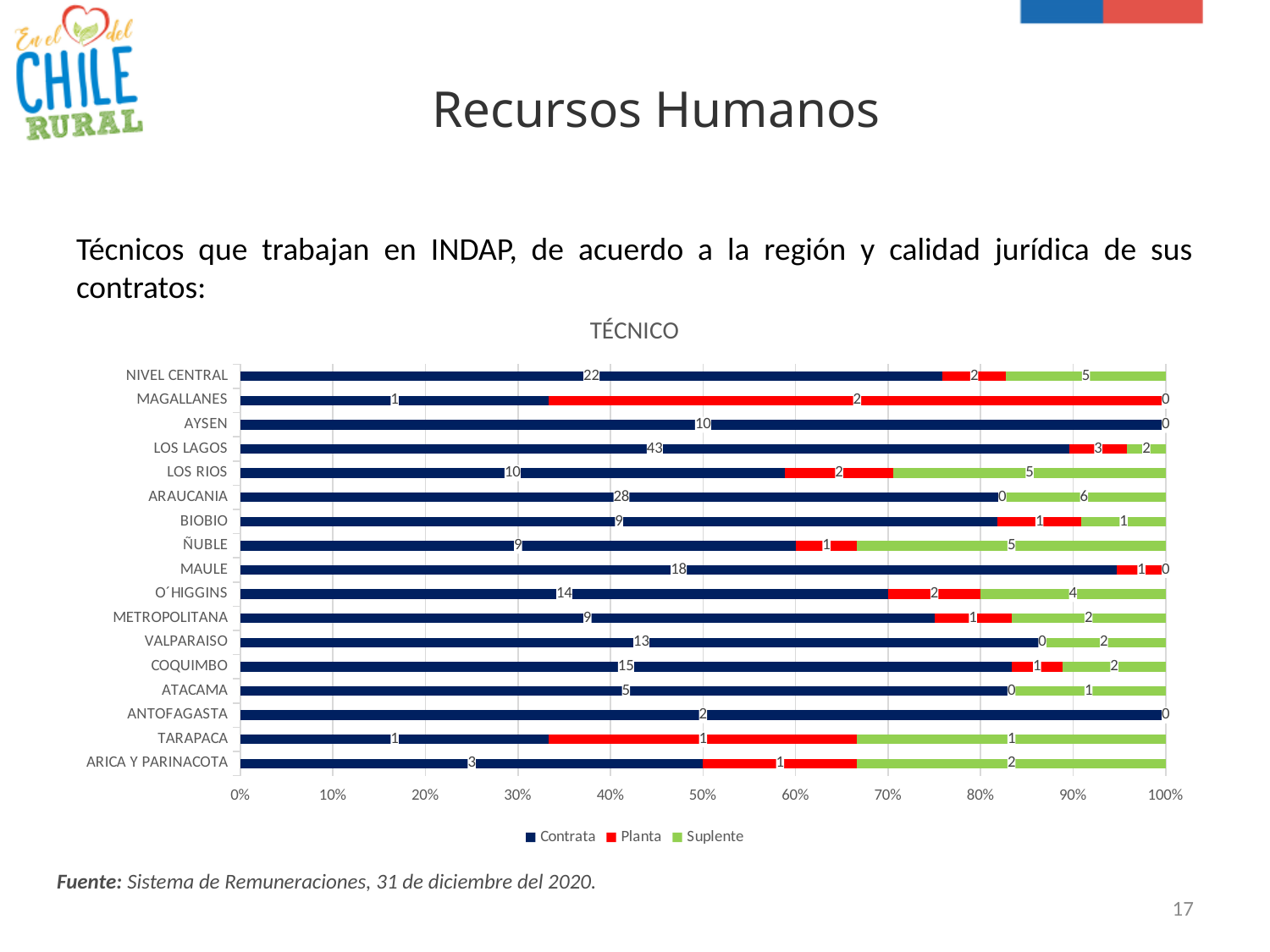
What is the Contrata value for LOS LAGOS? 43 What is the Suplente value for ARAUCANIA? 6 Which series is shown in green in the legend? Suplente How many regions (categories) are shown on the TÉCNICO chart? 17 How many series does the legend of the TÉCNICO chart list? 3 What is the total number of técnicos for NIVEL CENTRAL (Contrata + Planta + Suplente)? 29 What is the Planta value for NIVEL CENTRAL? 2 What is the difference between the Contrata values of ARAUCANIA and MAULE? 10 What kind of chart is shown on the slide? Stacked bar chart Which is larger, the Suplente value for LOS RIOS or the Suplente value for O´HIGGINS? LOS RIOS Which region has the highest Contrata value? LOS LAGOS What is the title of the chart? TÉCNICO